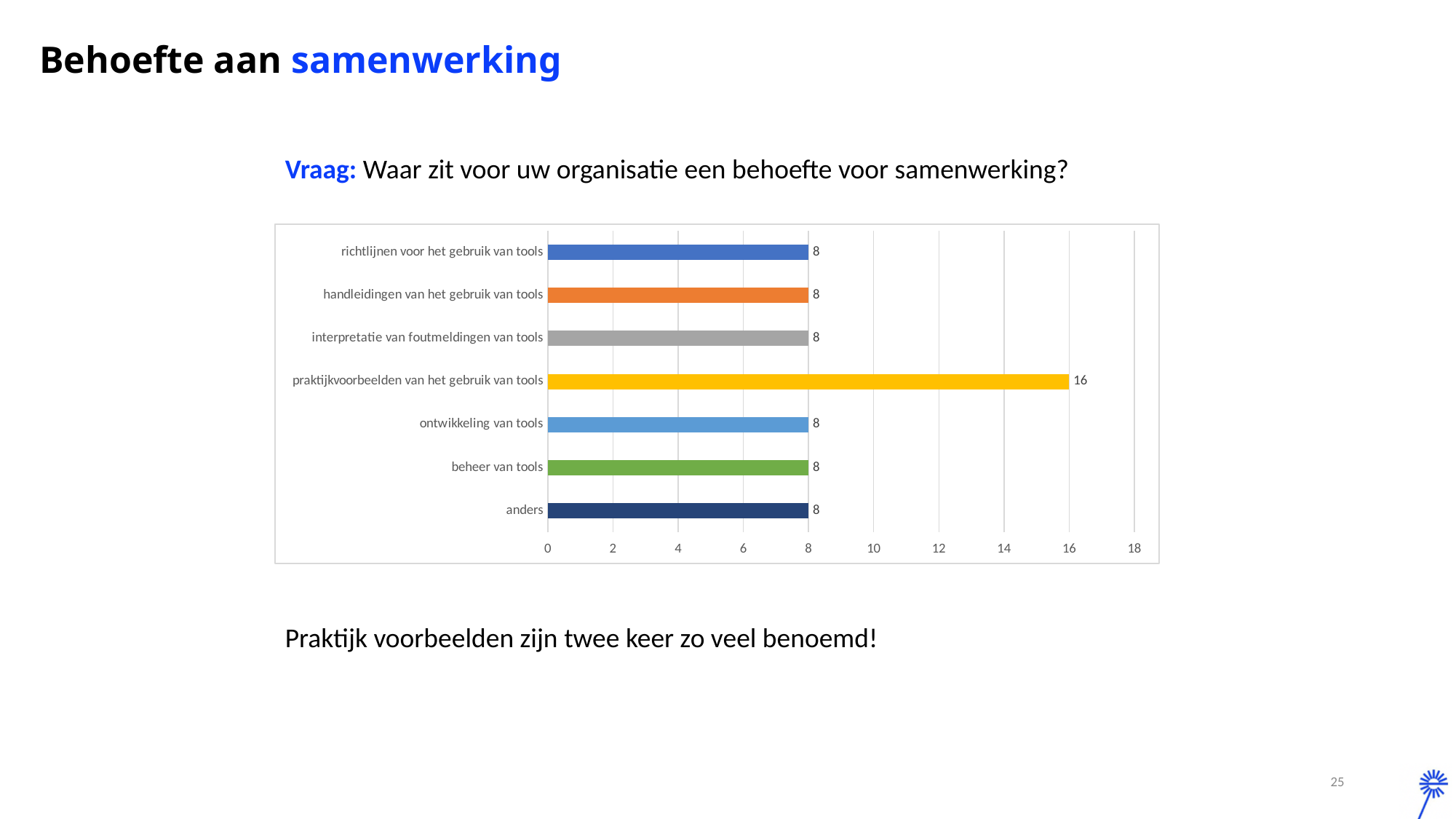
What is the highest value shown on the x axis? 18 What is the value for 'beheer van tools'? 8 Which is larger: the value for 'praktijkvoorbeelden van het gebruik van tools' or the value for 'handleidingen van het gebruik van tools'? praktijkvoorbeelden van het gebruik van tools Which category has the highest value? praktijkvoorbeelden van het gebruik van tools Is the value for 'praktijkvoorbeelden van het gebruik van tools' greater or less than 12? greater What colour is the bar for 'praktijkvoorbeelden van het gebruik van tools'? yellow What is the difference between the value for 'praktijkvoorbeelden van het gebruik van tools' and the value for 'ontwikkeling van tools'? 8 Is the value for 'richtlijnen voor het gebruik van tools' greater or less than 10? less How many categories are shown in the chart? 7 What kind of chart is shown on the slide? bar chart What is the value for 'anders'? 8 What is the value for 'praktijkvoorbeelden van het gebruik van tools'? 16